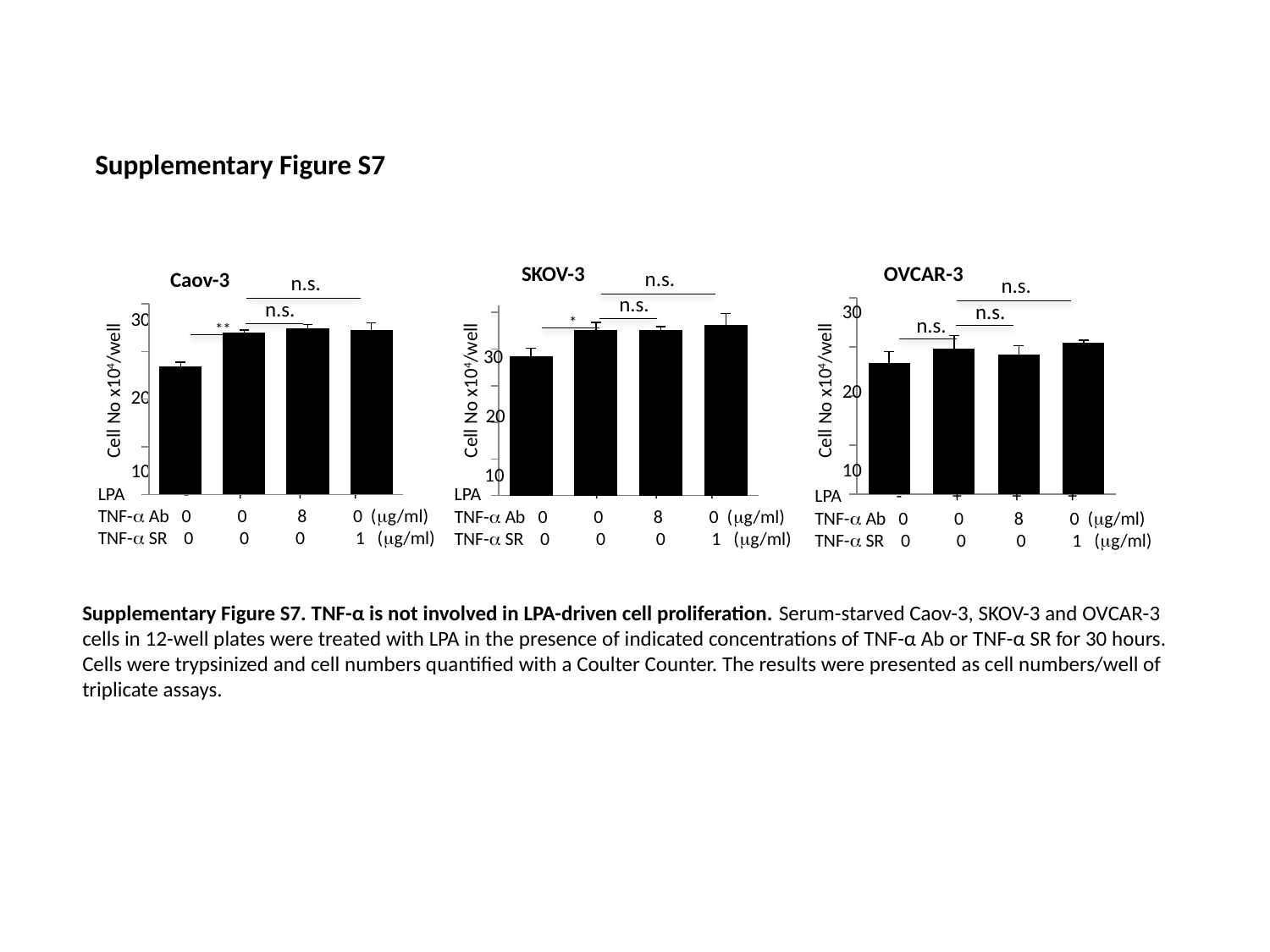
In the Caov-3 chart, is the value of the bar with TNF-α Ab 8 µg/ml greater or less than 30? less In the SKOV-3 chart, is the value of the bar with TNF-α SR 1 µg/ml greater or less than 30? greater In the SKOV-3 chart, which bar is the lowest? the first bar (TNF-α Ab 0, TNF-α SR 0) In the OVCAR-3 chart, is the value of the first bar greater or less than 20? greater How many charts are shown on the slide? 3 What kind of chart is the Caov-3 chart? bar chart In the Caov-3 chart, which is larger: the first bar or the second bar? the second bar In the Caov-3 chart, which bar is the lowest? the first bar (TNF-α Ab 0, TNF-α SR 0) What is the y-axis label of the OVCAR-3 chart? Cell No x10⁴/well In the SKOV-3 chart, which is larger: the first bar or the fourth bar (TNF-α SR 1 µg/ml)? the fourth bar How many bars does the SKOV-3 chart show? 4